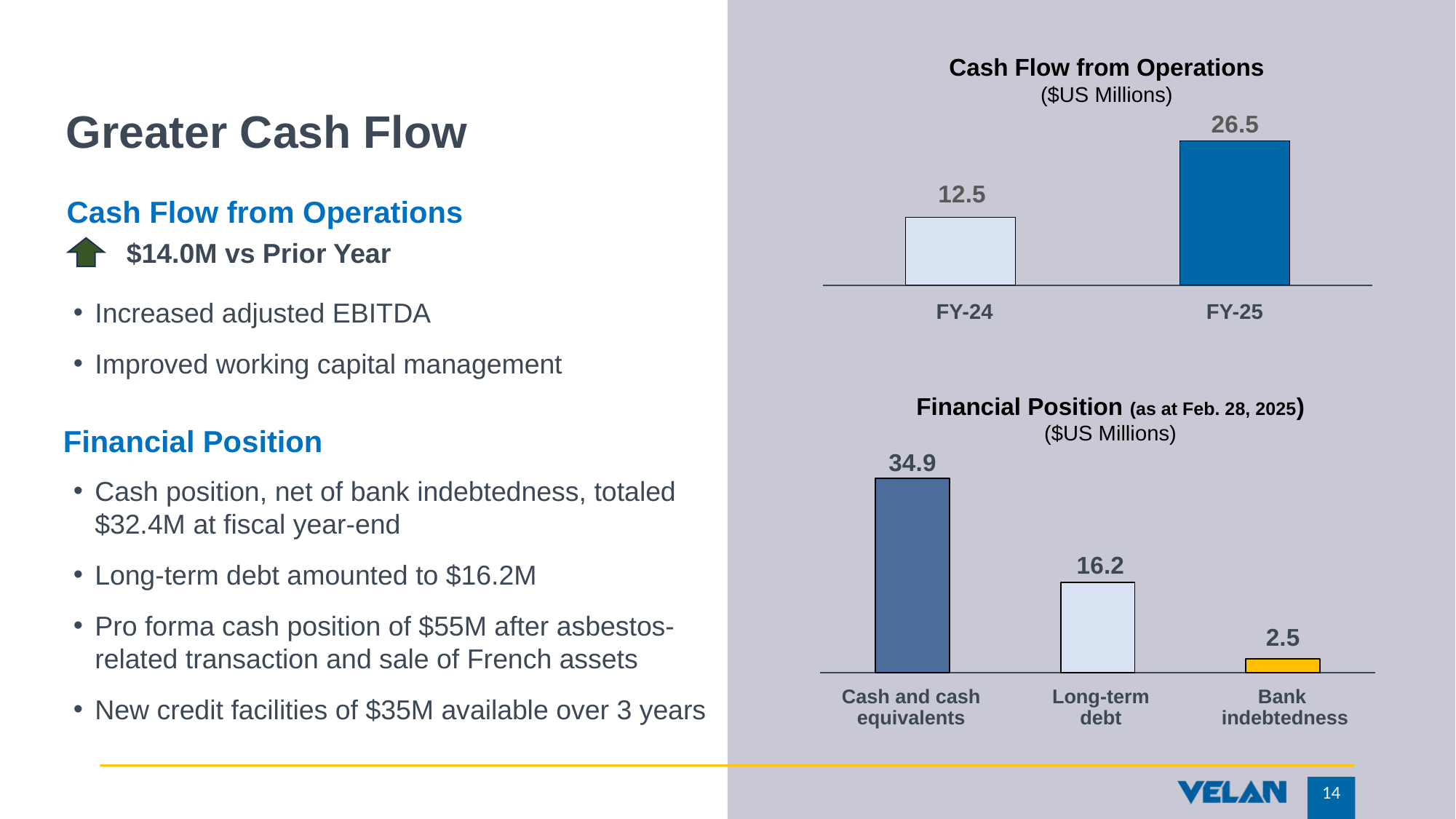
What kind of chart is the Cash Flow from Operations chart? bar chart In the Financial Position chart, what is the value for Cash and cash equivalents? 34.9 In the Financial Position chart, which category has the highest value? Cash and cash equivalents In the Cash Flow from Operations chart, what is the value for FY-25? 26.5 In the Financial Position chart, what unit is stated under the title? $US Millions In the Cash Flow from Operations chart, do values rise or fall from FY-24 to FY-25? rise In the Cash Flow from Operations chart, how many bars are plotted? 2 In the Cash Flow from Operations chart, what is the difference between FY-25 and FY-24? 14.0 In the Financial Position chart, what is the difference between Cash and cash equivalents and Bank indebtedness? 32.4 In the Cash Flow from Operations chart, what is the value for FY-24? 12.5 In the Financial Position chart, which category has the lowest value? Bank indebtedness In the Financial Position chart, what is the value for Long-term debt? 16.2